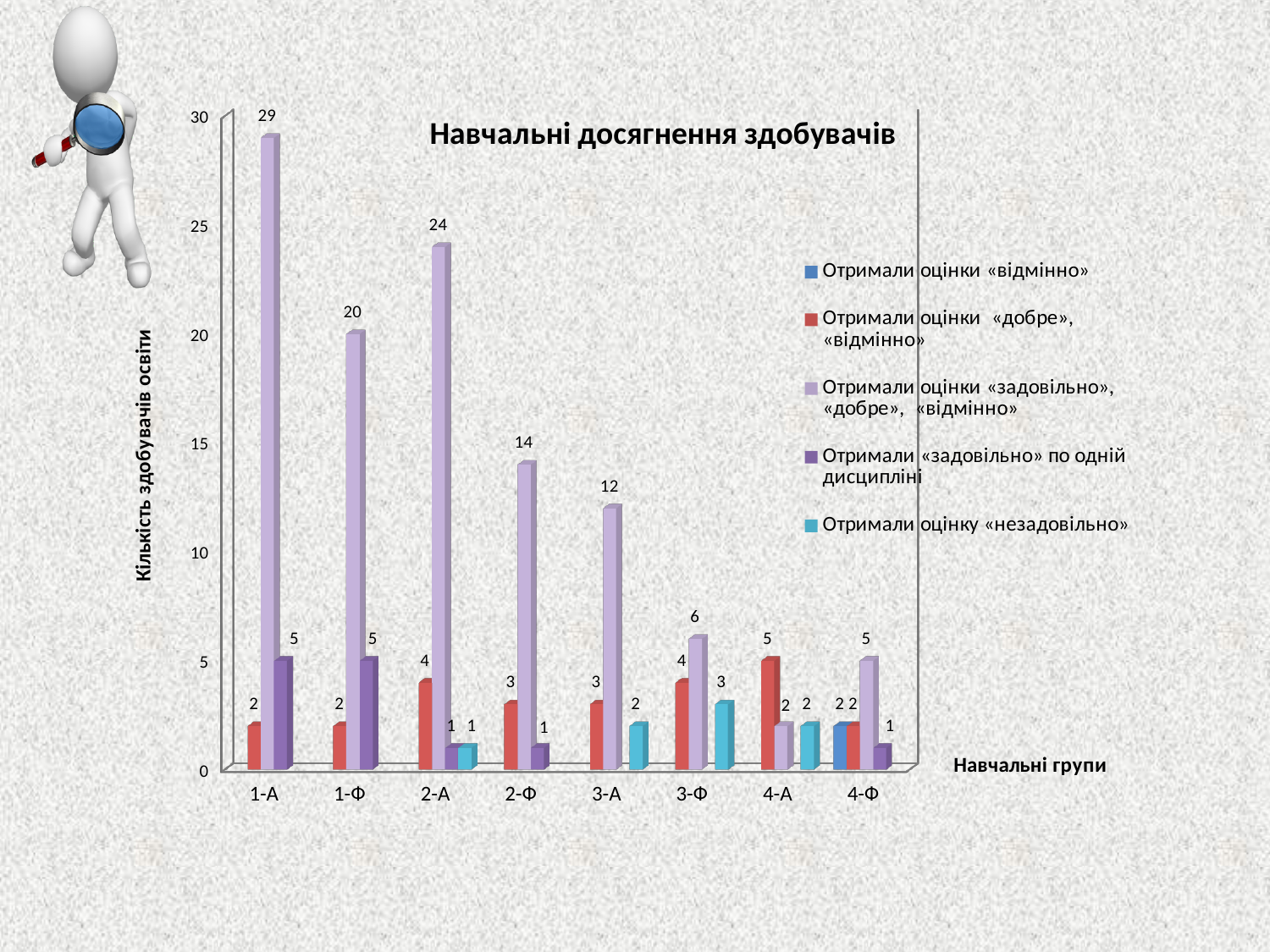
Which group has the lowest value in the series «Отримали оцінки «задовільно», «добре», «відмінно»»? 4-А How many series does the legend list? 5 What is the value for 3-Ф in the series «Отримали оцінку «незадовільно»»? 3 What is the value for 4-Ф in the series «Отримали оцінки «відмінно»»? 2 What kind of chart is shown on the slide? Bar chart Which group has the highest value in the series «Отримали оцінки «задовільно», «добре», «відмінно»»? 1-А What is the difference between 1-А and 1-Ф in the series «Отримали оцінки «задовільно», «добре», «відмінно»»? 9 What is the value for 2-А in the series «Отримали оцінки «задовільно», «добре», «відмінно»»? 24 How many groups are shown on the x axis? 8 Which is larger in the series «Отримали оцінки «задовільно», «добре», «відмінно»»: 2-Ф or 3-А? 2-Ф What is the value for 1-А in the series «Отримали оцінки «задовільно», «добре», «відмінно»»? 29 What is the value for 4-А in the series «Отримали оцінки «добре», «відмінно»»? 5